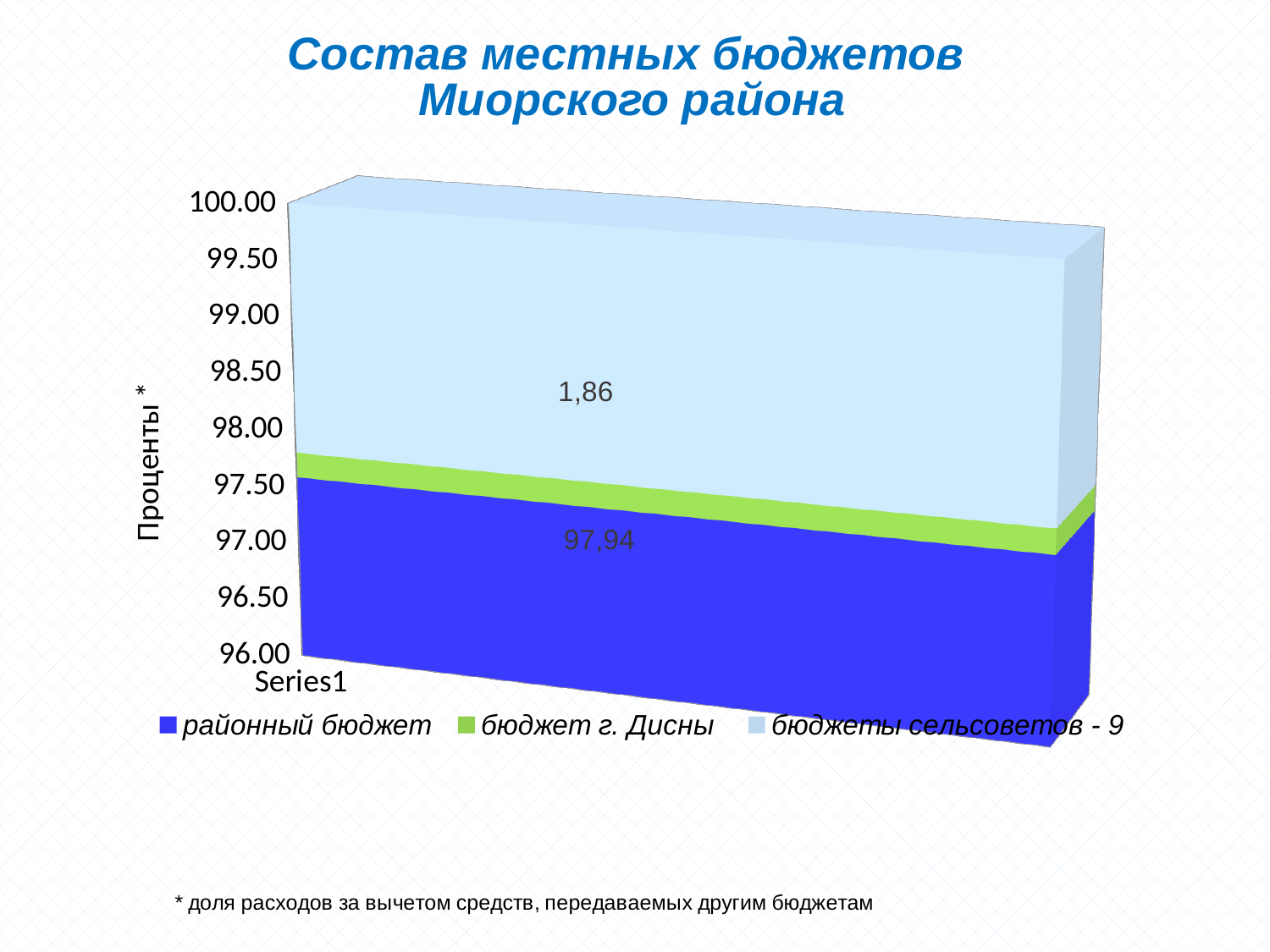
Which is larger, the segment for бюджет г. Дисны or the segment for бюджеты сельсоветов - 9? бюджеты сельсоветов - 9 How many series does the legend list? 3 Which series has the largest segment in the bar? районный бюджет What is the label of the vertical axis? Проценты * What is the difference between the value for районный бюджет and the value for бюджеты сельсоветов - 9? 96,08 What is the title of the chart? Состав местных бюджетов Миорского района How many categories are shown on the x axis? 1 What kind of chart is shown on the slide? Stacked area chart Which series has the smallest segment in the bar? бюджет г. Дисны Which is larger, the value for районный бюджет or the value for бюджеты сельсоветов - 9? районный бюджет What is the value shown for бюджеты сельсоветов - 9? 1,86 What is the value shown for районный бюджет? 97,94